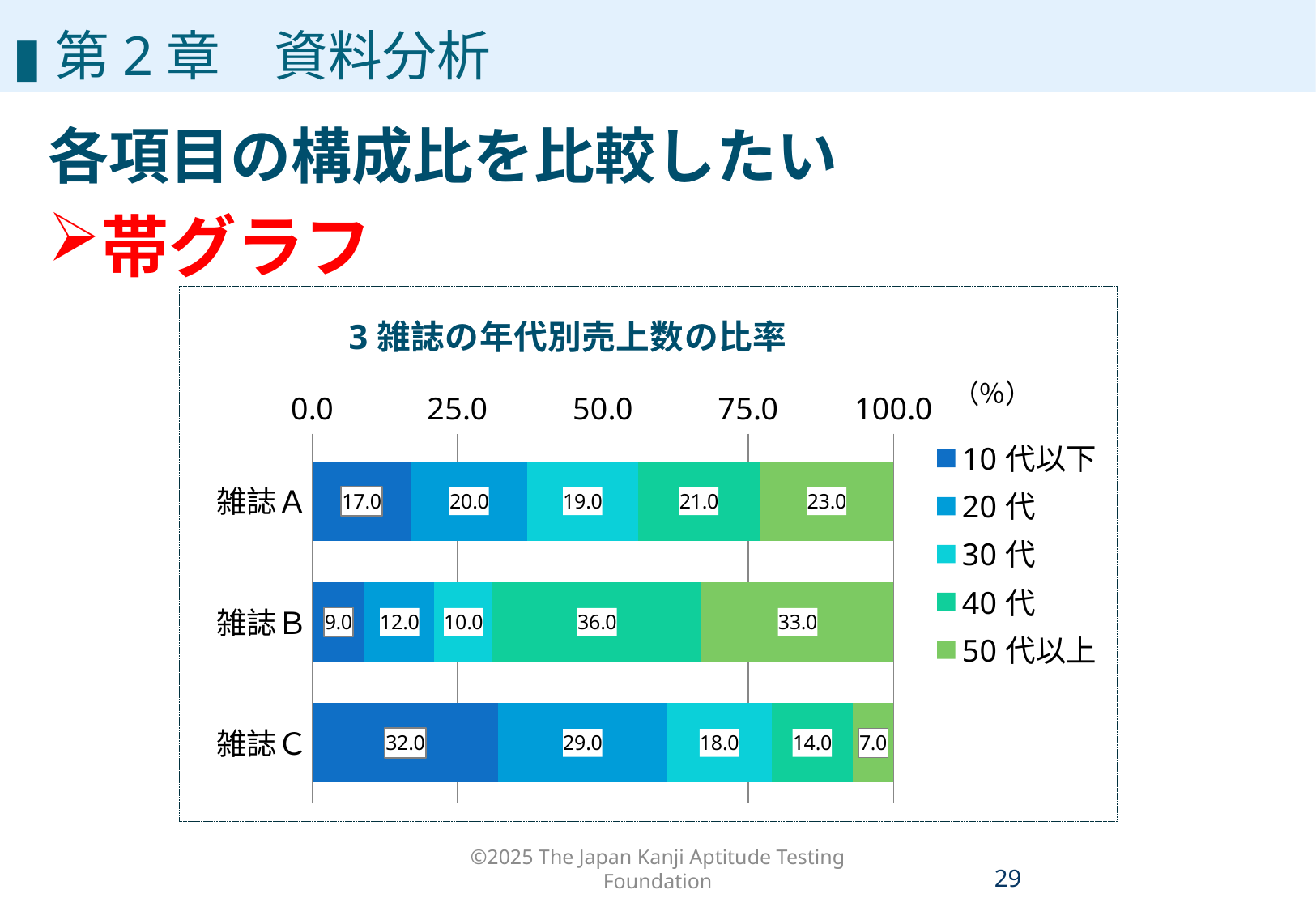
How many magazines (categories) are shown on the chart? 3 Which magazine has the highest value for 10代以下? 雑誌C What is the total of the stacked bar for 雑誌B? 100.0 What is the difference between the 40代 values of 雑誌B and 雑誌A? 15.0 What is the value for 50代以上 in 雑誌C? 7.0 What is the value for 40代 in 雑誌B? 36.0 Which magazine has the lowest value for 50代以上? 雑誌C Which is larger: the 30代 value for 雑誌A or for 雑誌C? 雑誌A What kind of chart is shown on the slide? Stacked bar chart How many series does the legend list? 5 What is the title of the chart? ３雑誌の年代別売上数の比率 What is the value for 20代 in 雑誌A? 20.0